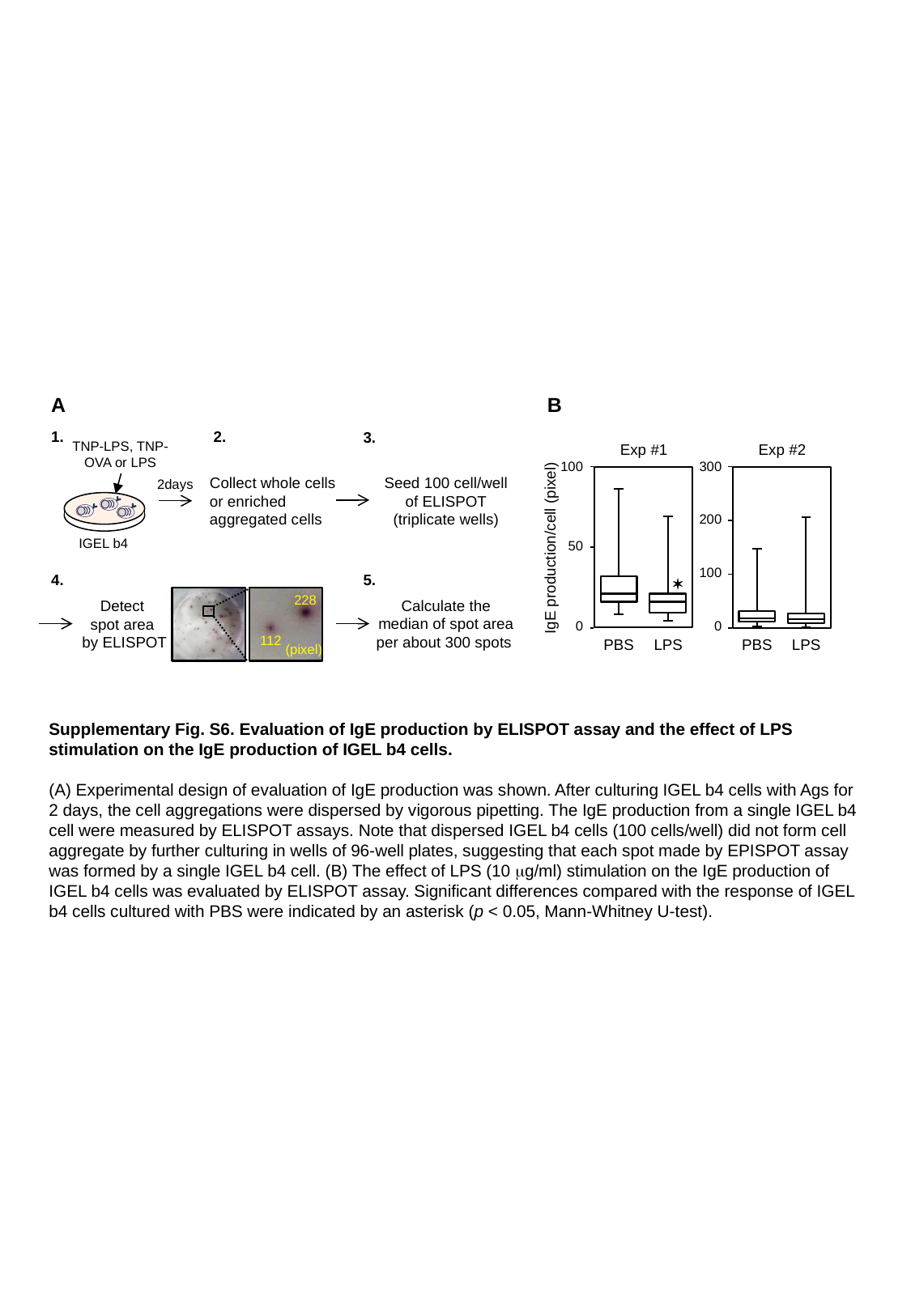
In the Exp #2 chart, which category has the higher upper whisker, PBS or LPS? LPS In the Exp #1 chart, is the top of the upper whisker for PBS greater or less than 50? greater In the Exp #2 chart, what are the two categories on the x axis? PBS and LPS What is the y-axis label shared by the Exp #1 and Exp #2 charts? IgE production/cell (pixel) In the Exp #2 chart, is the top of the upper whisker for LPS greater or less than 300? less In the Exp #2 chart, is the median for LPS greater or less than 100? less What is the highest y-axis tick value shown on the Exp #2 chart? 300 In the Exp #1 chart, how many categories are shown on the x axis? 2 What kind of chart is used in panel B for Exp #1? box plot In the Exp #1 chart, which category has the higher upper whisker, PBS or LPS? PBS